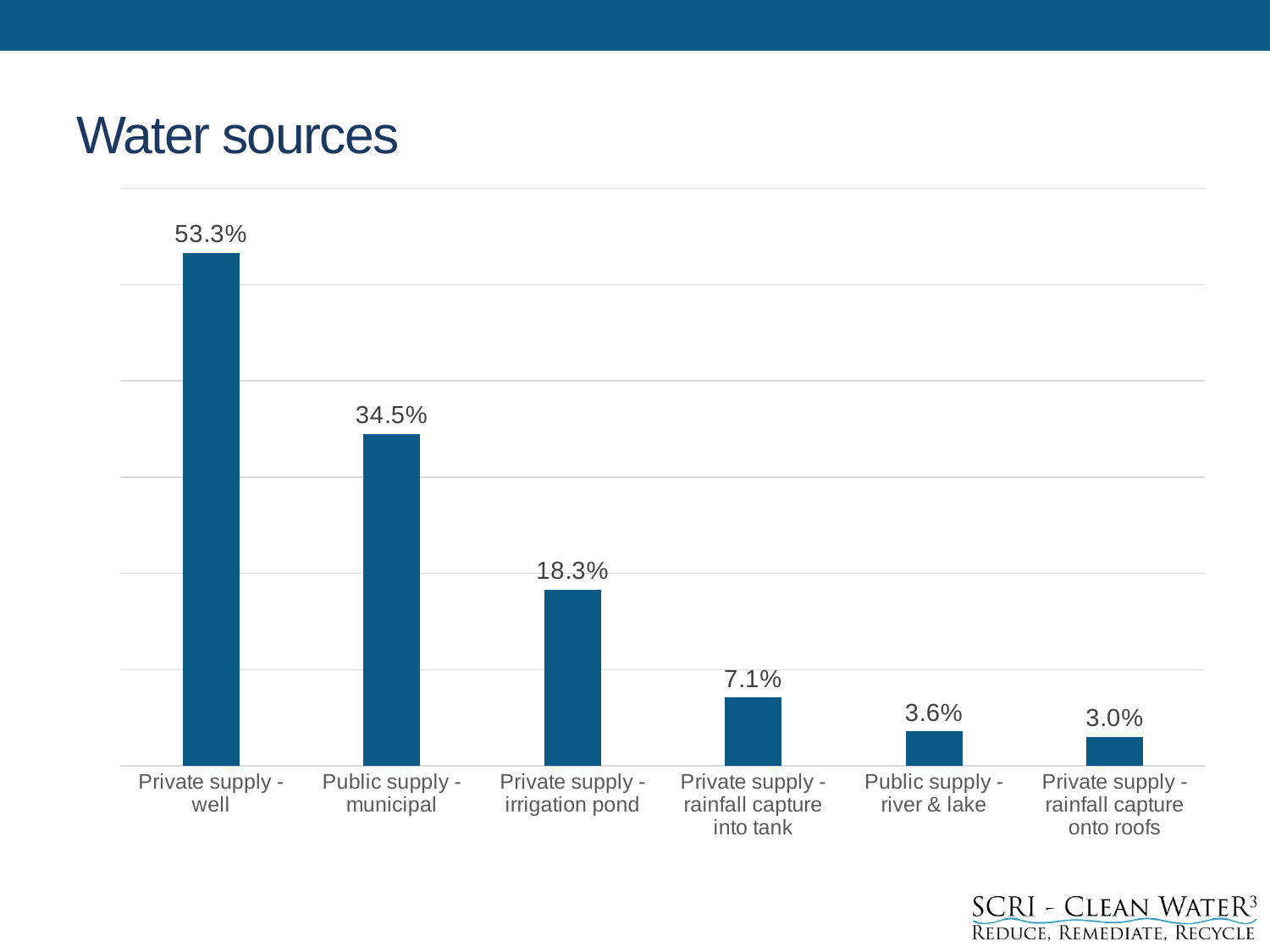
What kind of chart is shown on the slide? Bar chart How many water source categories are shown in the chart? 6 Which water source has the lowest value? Private supply - rainfall capture onto roofs What is the value for Private supply - rainfall capture into tank? 7.1% What is the difference between Private supply - well and Public supply - municipal? 18.8% What is the value for Public supply - municipal? 34.5% What is the value for Private supply - irrigation pond? 18.3% What is the value for Private supply - well? 53.3% What is the title of the slide? Water sources What is the value for Public supply - river & lake? 3.6% Which water source has the highest value? Private supply - well Which is larger, Private supply - irrigation pond or Private supply - rainfall capture into tank? Private supply - irrigation pond